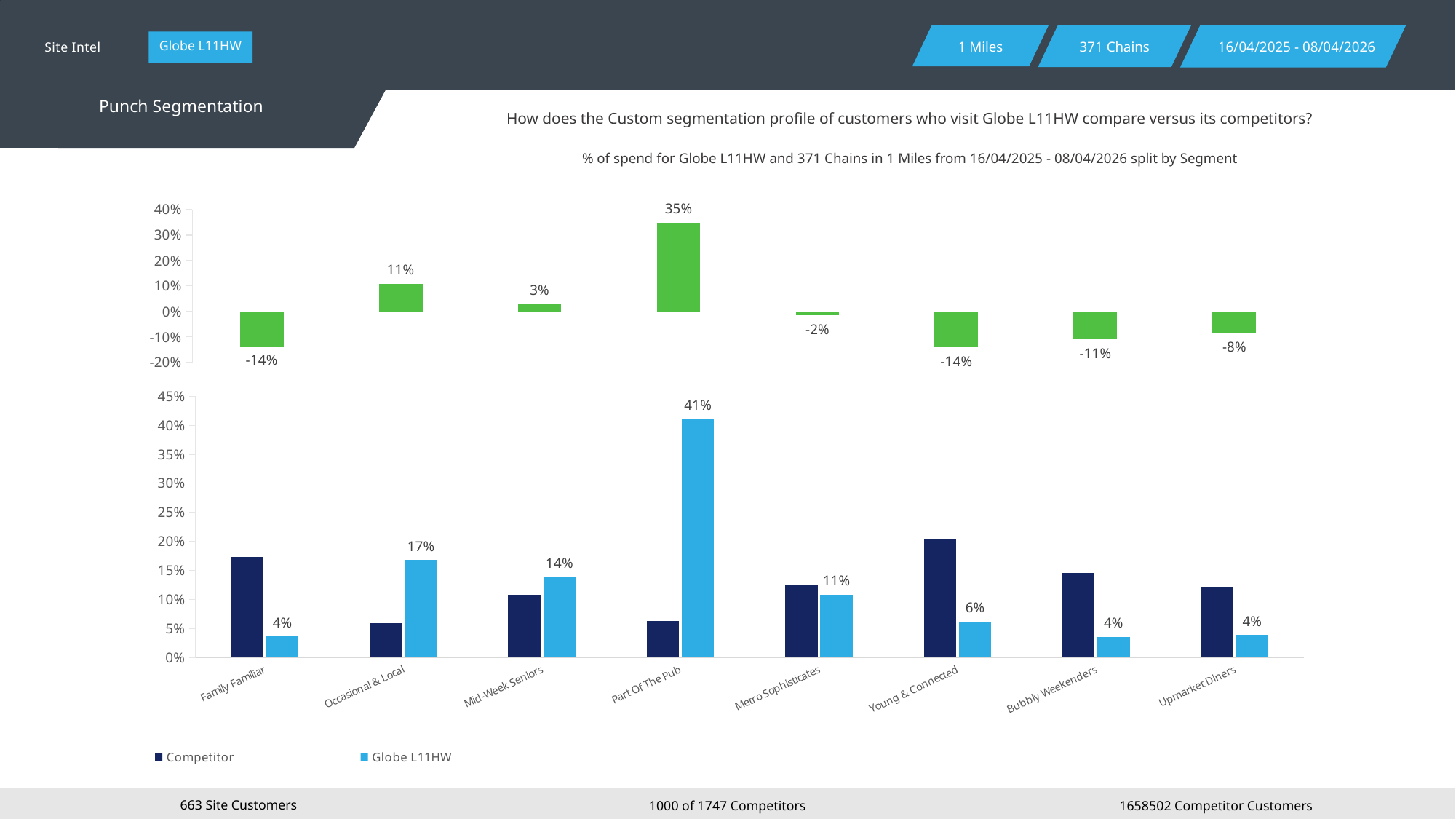
In the bottom chart, which is larger for Family Familiar, the Competitor bar or the Globe L11HW bar? Competitor In the bottom chart, what is the difference between the Globe L11HW values for Occasional & Local and Mid-Week Seniors? 3% How many series does the legend of the bottom chart list? 2 In the bottom chart, is the Competitor value for Young & Connected greater or less than 15%? greater In the top chart, which segment has the lowest value, Metro Sophisticates or Bubbly Weekenders? Bubbly Weekenders In the top chart, what is the value for Occasional & Local? 11% In the bottom chart, what is the Globe L11HW value for Part Of The Pub? 41% In the bottom chart, which segment has the lowest Globe L11HW value among Occasional & Local, Mid-Week Seniors and Young & Connected? Young & Connected What type of chart is the bottom chart? Bar chart In the top chart, which segment has the highest value? Part Of The Pub How many segments are shown on the x axis of the bottom chart? 8 In the bottom chart, is the Competitor value for Occasional & Local greater or less than 10%? less